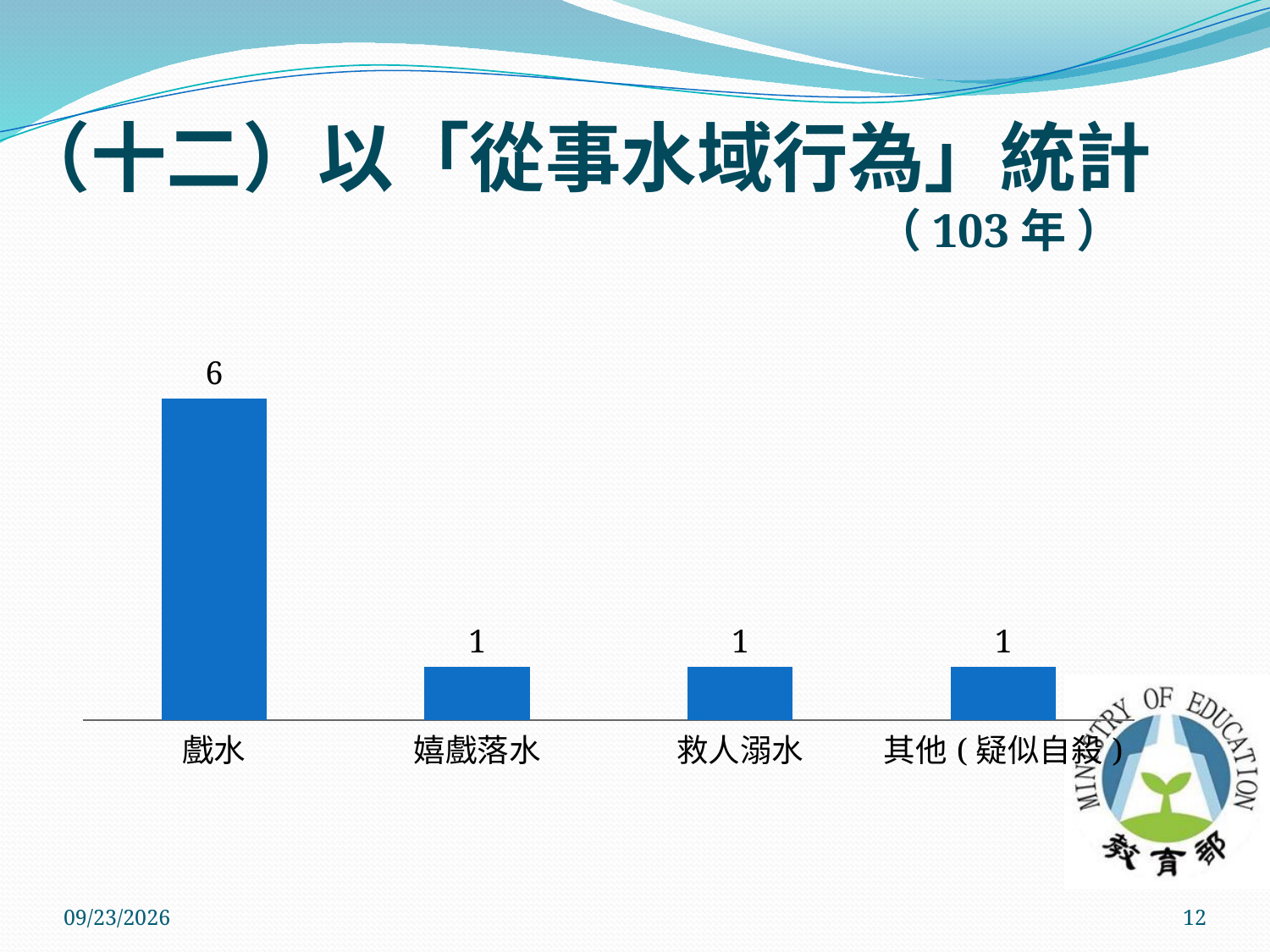
How many categories have a value of 1? 3 What year is indicated in the slide title for this statistic? 103 年 Which category has the highest value? 戲水 How many categories are shown in the chart? 4 Which is larger, the value for 戲水 or the value for 救人溺水? 戲水 What is the value for 戲水? 6 What is the difference between the values for 戲水 and 嬉戲落水? 5 What is the value for 其他（疑似自殺）? 1 What is the value for 嬉戲落水? 1 What is the value for 救人溺水? 1 What kind of chart is shown on the slide? Bar chart What is the total of all the values shown in the chart? 9